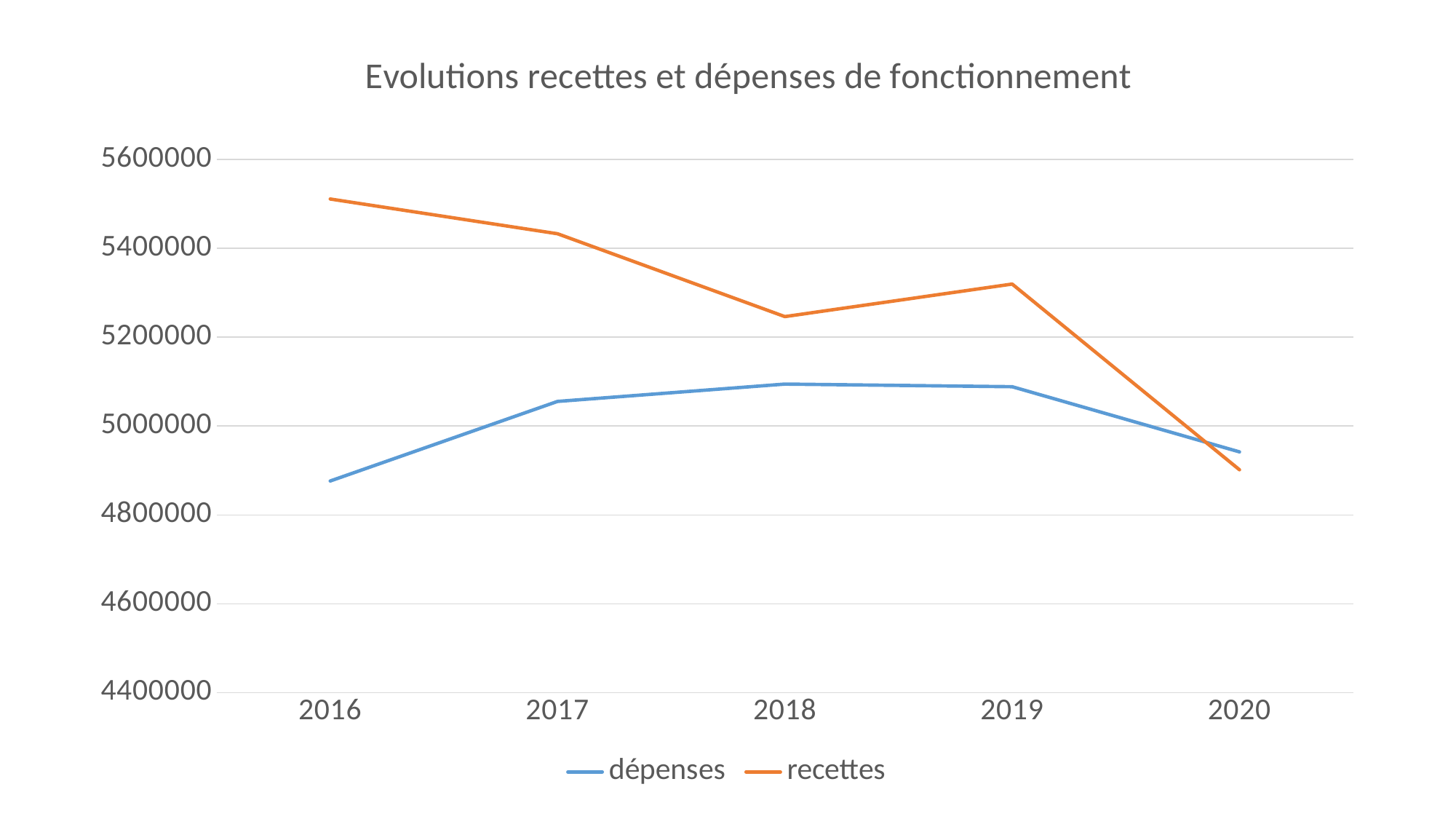
In which year is the dépenses value lowest? 2016 How many years are plotted along the x axis? 5 Do the recettes values rise or fall from 2016 to 2018? fall Is the value for recettes in 2020 greater or less than 5000000? less Which colour is used for the recettes series? orange How many series does the legend list? 2 What kind of chart is shown on the slide? line chart Is the value for recettes in 2016 greater or less than 5400000? greater Is the value for dépenses in 2016 greater or less than 5000000? less In 2016, which is larger: recettes or dépenses? recettes What is the title of the chart? Evolutions recettes et dépenses de fonctionnement In which year is the recettes value highest? 2016